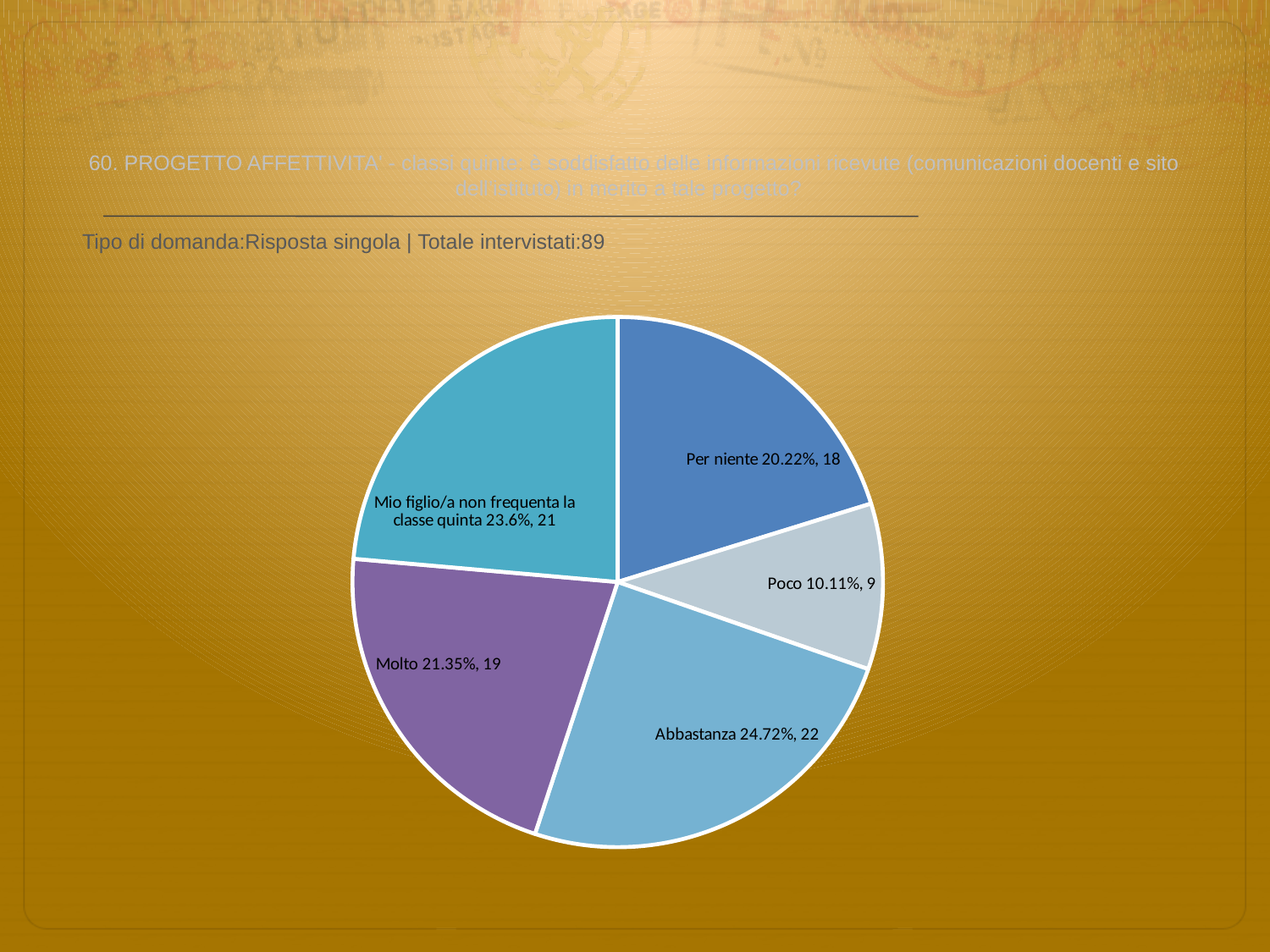
How many slices does the pie chart have? 5 What percentage is shown for the 'Per niente' slice? 20.22% How many respondents chose 'Poco'? 9 What is the difference in respondent count between 'Abbastanza' and 'Poco'? 13 Which slice has the largest share of the pie? Abbastanza How many respondents chose 'Molto'? 19 What kind of chart is shown on the slide? pie chart Which slice has the smallest share of the pie? Poco Which has more respondents, 'Molto' or 'Per niente'? Molto What percentage is shown for 'Abbastanza'? 24.72% What percentage is shown for 'Mio figlio/a non frequenta la classe quinta'? 23.6% What is the total number of respondents stated on the slide? 89